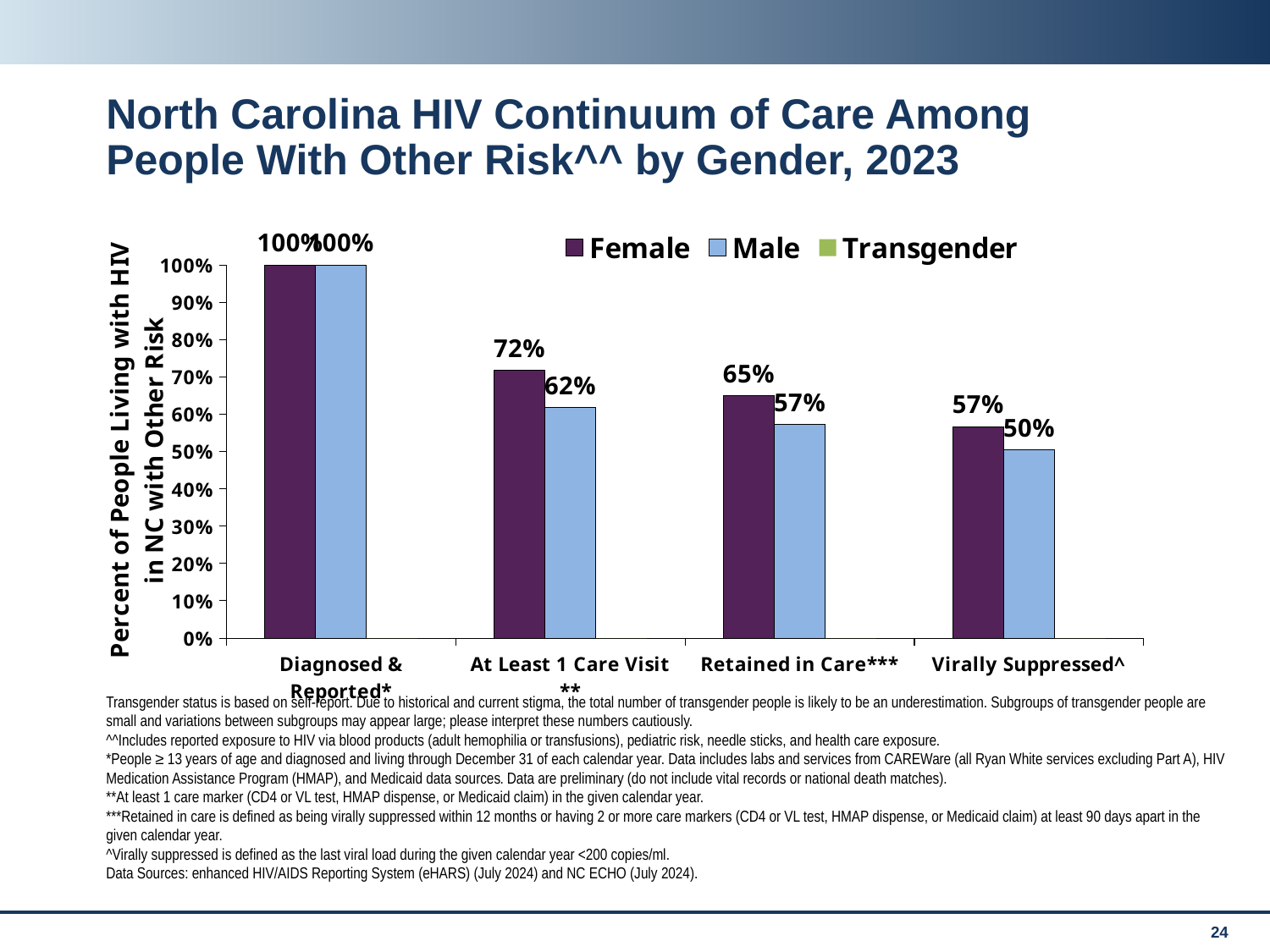
What is the Female value for At Least 1 Care Visit? 72% What is the Male value for Retained in Care? 57% What is the difference between the Female and Male values for Retained in Care? 8% Which is larger for Virally Suppressed, the Female value or the Male value? Female How many categories are shown on the x axis? 4 Do the Female values rise or fall from Diagnosed & Reported to Virally Suppressed? Fall What kind of chart is shown on the slide? Bar chart What is the difference between the Female and Male values for At Least 1 Care Visit? 10% What is the Male value for Virally Suppressed? 50% How many series does the legend list? 3 Which category has the lowest Male value? Virally Suppressed What is the Female value for Diagnosed & Reported? 100%